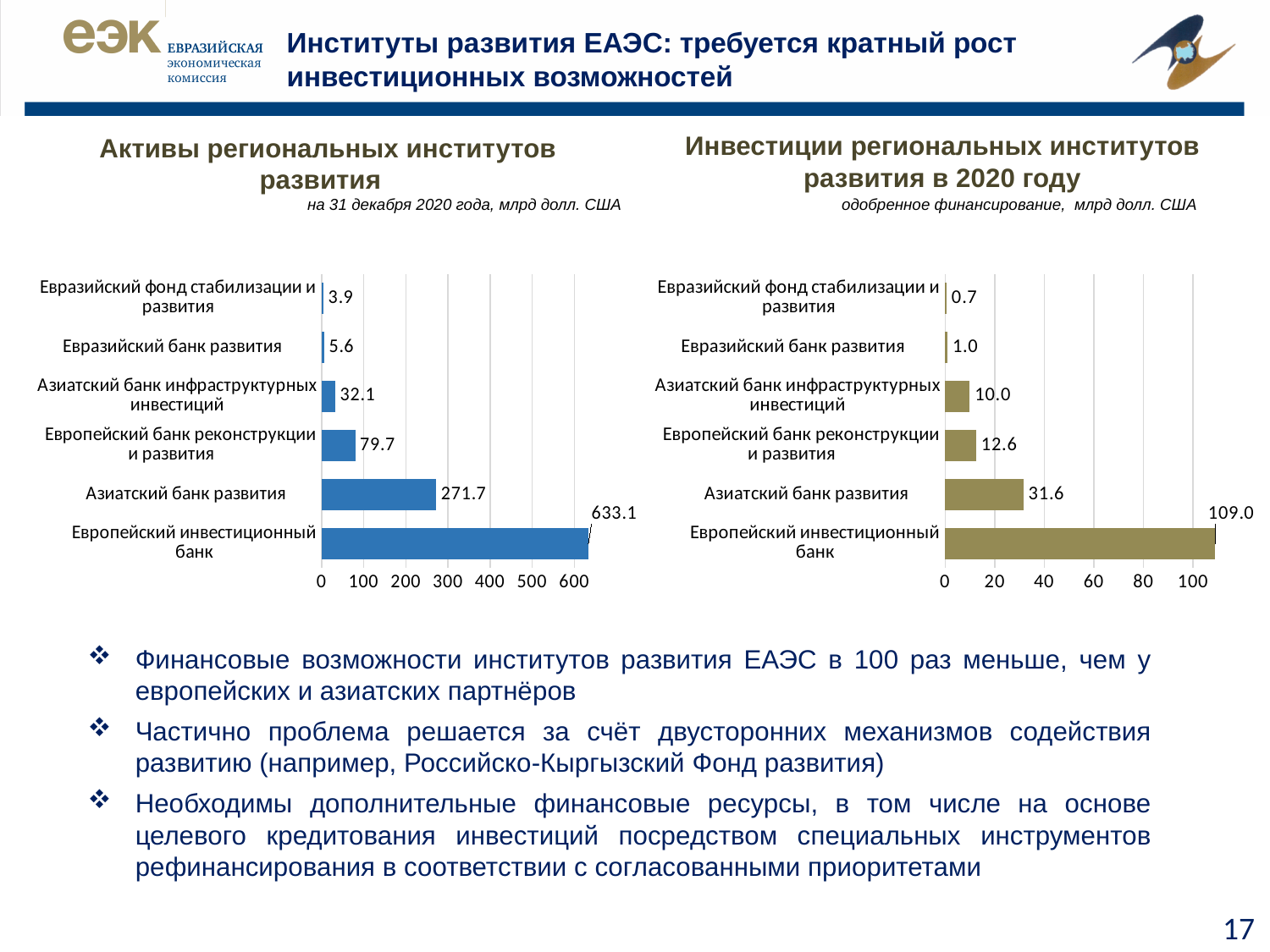
On the chart 'Активы региональных институтов развития', which category has the lowest value? Евразийский фонд стабилизации и развития On the chart 'Инвестиции региональных институтов развития в 2020 году', what is the difference between Европейский банк реконструкции и развития and Азиатский банк инфраструктурных инвестиций? 2.6 What unit is stated in the subtitle of the chart 'Инвестиции региональных институтов развития в 2020 году'? млрд долл. США On the chart 'Инвестиции региональных институтов развития в 2020 году', what is the value for Азиатский банк развития? 31.6 On the chart 'Активы региональных институтов развития', what is the difference between Азиатский банк развития and Европейский банк реконструкции и развития? 192.0 How many categories are shown on the chart 'Активы региональных институтов развития'? 6 On the chart 'Активы региональных институтов развития', what is the value for Евразийский банк развития? 5.6 On the chart 'Активы региональных институтов развития', what is the value for Европейский инвестиционный банк? 633.1 On the chart 'Инвестиции региональных институтов развития в 2020 году', is the value for Европейский инвестиционный банк greater or less than 100? greater On the chart 'Инвестиции региональных институтов развития в 2020 году', which category has the highest value? Европейский инвестиционный банк What type of chart is 'Инвестиции региональных институтов развития в 2020 году'? bar chart On the chart 'Активы региональных институтов развития', which is larger: Евразийский банк развития or Азиатский банк инфраструктурных инвестиций? Азиатский банк инфраструктурных инвестиций